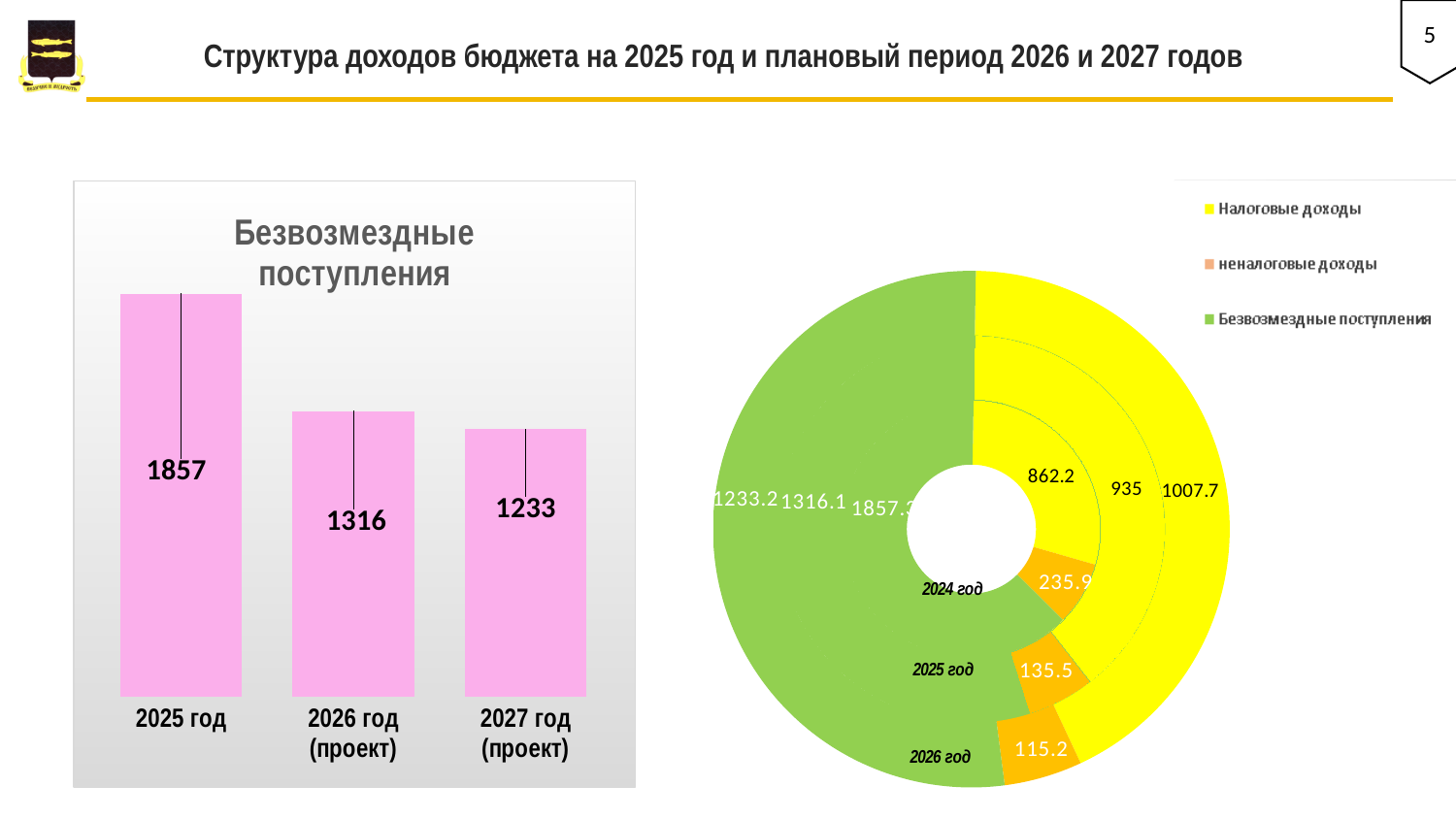
In the bar chart titled 'Безвозмездные поступления', what is the value for 2025 год? 1857 In the bar chart titled 'Безвозмездные поступления', what is the value for 2026 год (проект)? 1316 What kind of chart is the chart on the left of the slide? bar chart How many series does the legend of the doughnut chart on the right list? 3 In the bar chart titled 'Безвозмездные поступления', which year has the lowest value? 2027 год (проект) In the bar chart titled 'Безвозмездные поступления', what is the difference between the values for 2025 год and 2027 год (проект)? 624 In the bar chart titled 'Безвозмездные поступления', how many bars are shown? 3 In the bar chart titled 'Безвозмездные поступления', which year has the highest value? 2025 год What kind of chart is the chart on the right of the slide? doughnut chart In the bar chart titled 'Безвозмездные поступления', do the values rise or fall from 2025 to 2027? fall In the doughnut chart on the right, which series is shown in yellow? Налоговые доходы In the bar chart titled 'Безвозмездные поступления', what is the value for 2027 год (проект)? 1233